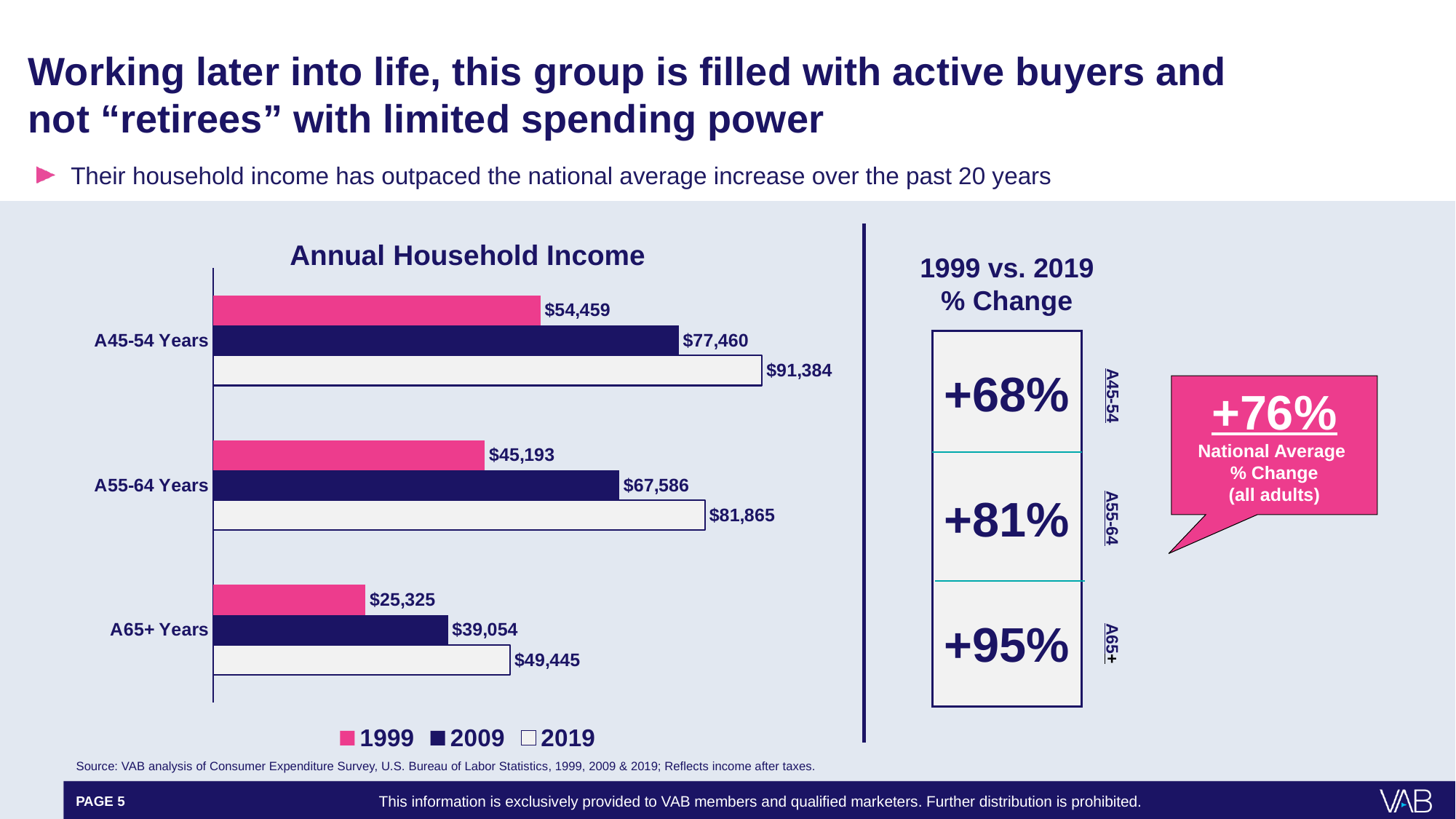
What is the difference between the 2019 and 1999 annual household income for A45-54 Years? $36,925 How many series does the legend of the Annual Household Income chart list? 3 Which age group has the lowest 1999 annual household income? A65+ Years How many age groups are shown in the Annual Household Income chart? 3 What is the 1999 annual household income for A65+ Years? $25,325 What is the difference between the 2019 and 2009 annual household income for A65+ Years? $10,391 Which series in the Annual Household Income chart is shown in pink? 1999 What is the 2019 annual household income for A45-54 Years? $91,384 Which age group has the highest 2019 annual household income? A45-54 Years What kind of chart is the Annual Household Income chart? Bar chart What is the 2009 annual household income for A55-64 Years? $67,586 Which is larger: the 2009 income for A55-64 Years or the 2019 income for A65+ Years? 2009 income for A55-64 Years